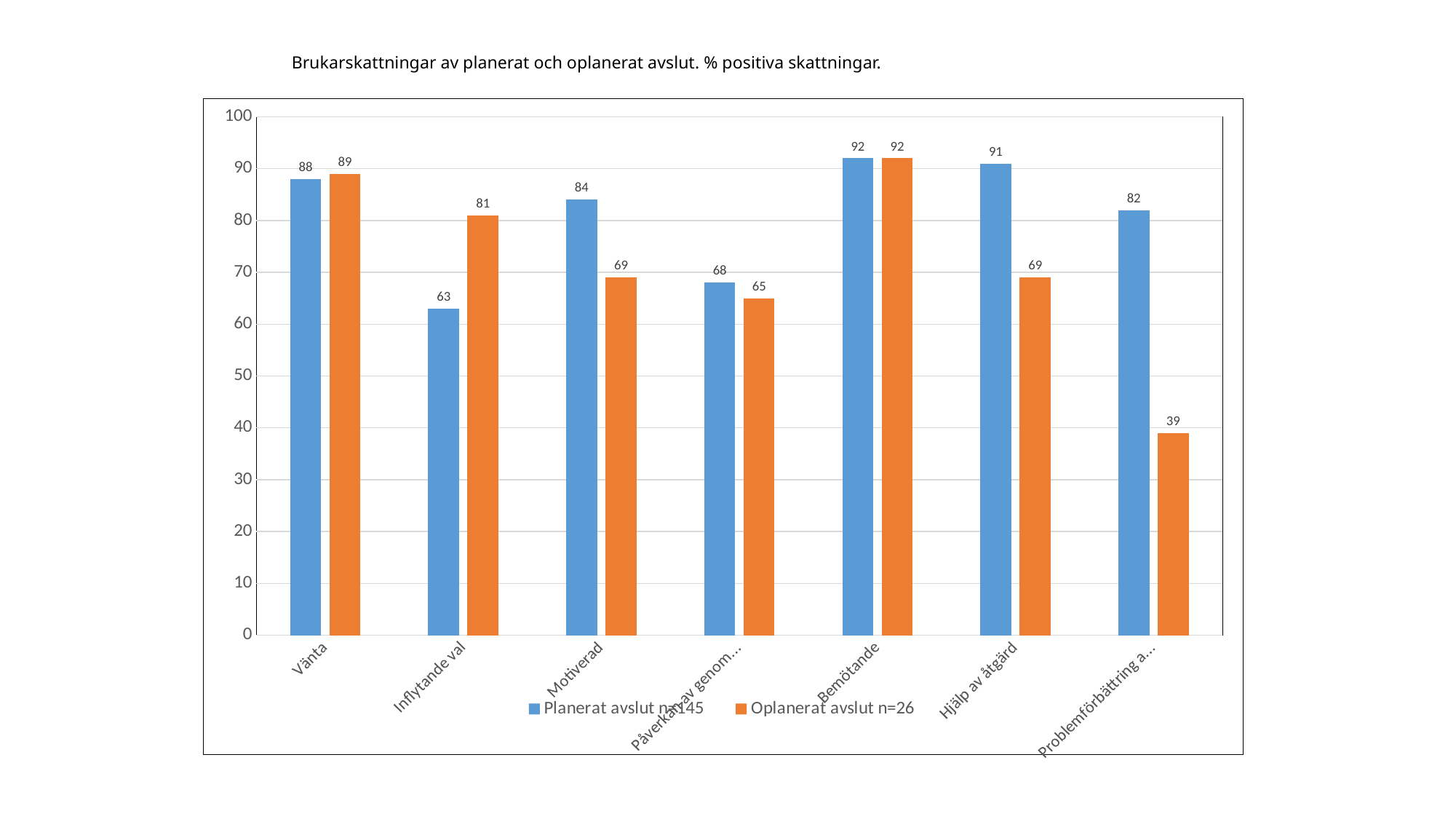
What is the value for Planerat avslut n=145 in the Vänta category? 88 What is the value for Oplanerat avslut n=26 in the Hjälp av åtgärd category? 69 How many series does the legend list? 2 What is the value for both series in the Bemötande category? 92 What colour are the bars for Oplanerat avslut n=26? orange In the Motiverad category, which series has the larger value, Planerat avslut n=145 or Oplanerat avslut n=26? Planerat avslut n=145 Which category has the lowest value for Oplanerat avslut n=26? Problemförbättring a... How many categories are shown on the x axis? 7 What is the difference between Planerat avslut n=145 and Oplanerat avslut n=26 in the Inflytande val category? 18 What type of chart is shown on the slide? bar chart What is the value for Oplanerat avslut n=26 in the Inflytande val category? 81 Which category has the lowest value for Planerat avslut n=145? Inflytande val